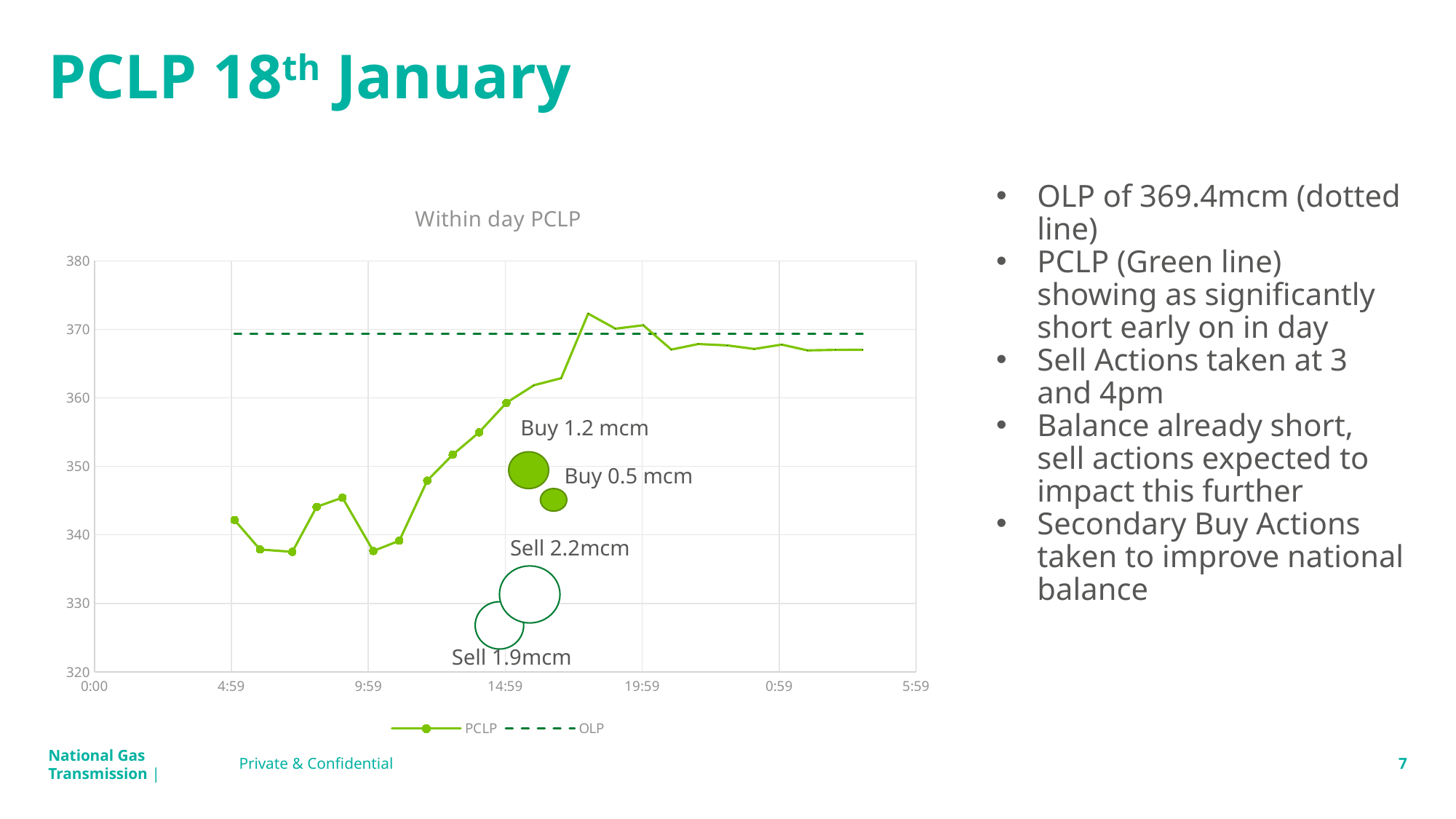
Is the PCLP value at 0:59 greater or less than 370? less What type of chart is shown on the slide? line chart At 4:59, which series has the higher value, PCLP or OLP? OLP Which series is drawn as a dotted line in the chart? OLP Is the PCLP value at 4:59 greater or less than 350? less Between 9:59 and 19:59, does the PCLP line generally rise or fall? rise Is the PCLP value at 9:59 greater or less than 340? less What is the title of the chart? Within day PCLP What is the size of the larger sell action annotated on the chart? Sell 2.2mcm How many series does the chart legend list? 2